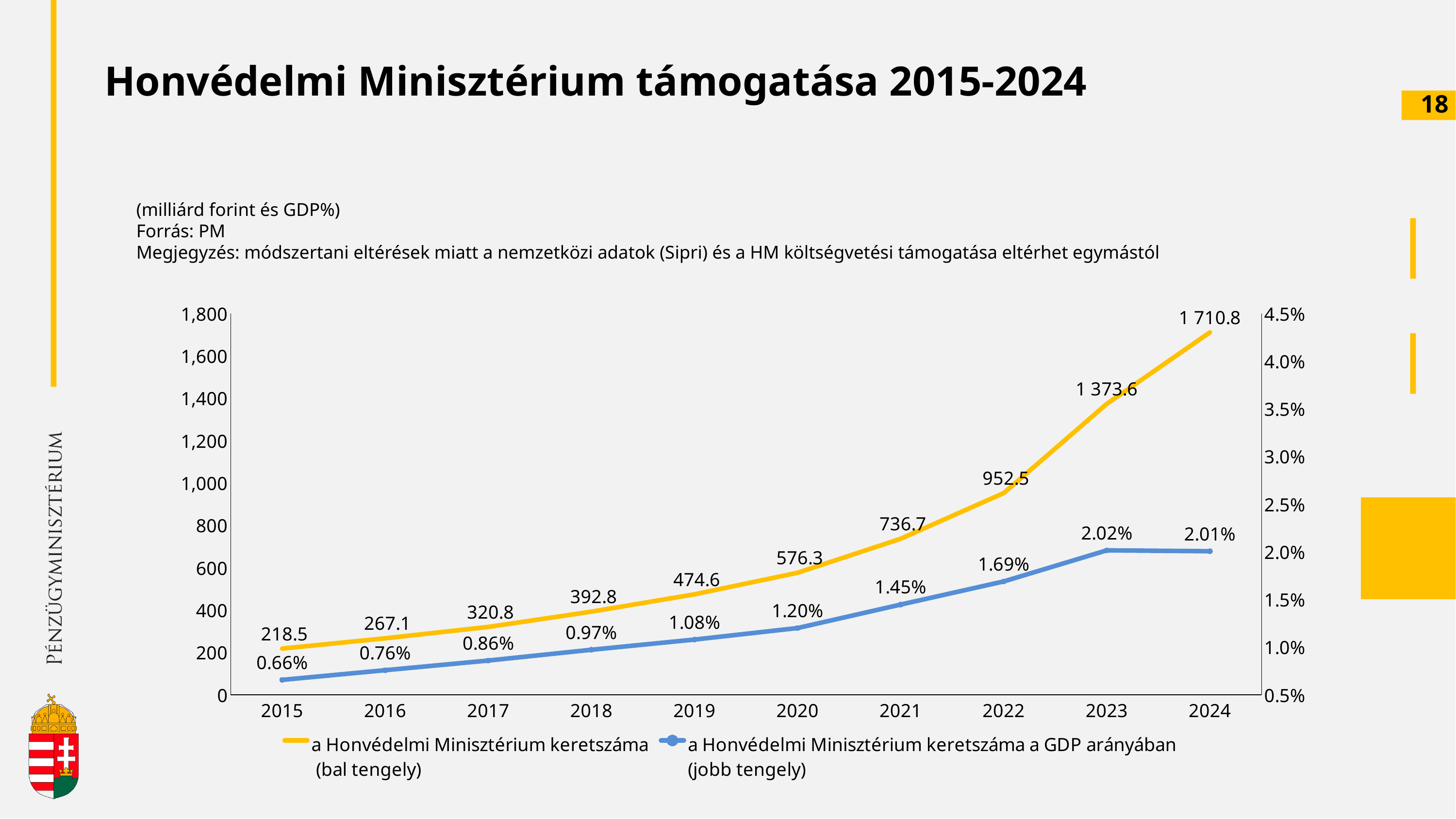
What is the value of 'a Honvédelmi Minisztérium keretszáma (bal tengely)' for 2015? 218.5 What is the value of 'a Honvédelmi Minisztérium keretszáma a GDP arányában (jobb tengely)' for 2021? 1.45% What is the difference between the 2024 and 2023 values of 'a Honvédelmi Minisztérium keretszáma (bal tengely)'? 337.2 How many series does the legend list? 2 What is the value of 'a Honvédelmi Minisztérium keretszáma (bal tengely)' for 2024? 1 710.8 In which year is 'a Honvédelmi Minisztérium keretszáma a GDP arányában (jobb tengely)' at its lowest? 2015 Which year has the larger value for 'a Honvédelmi Minisztérium keretszáma (bal tengely)', 2019 or 2020? 2020 What is the value of 'a Honvédelmi Minisztérium keretszáma a GDP arányában (jobb tengely)' for 2023? 2.02% In which year is 'a Honvédelmi Minisztérium keretszáma (bal tengely)' at its highest? 2024 Does 'a Honvédelmi Minisztérium keretszáma (bal tengely)' rise or fall from 2015 to 2024? rise How many years are shown on the x axis? 10 What type of chart is shown on the slide? line chart